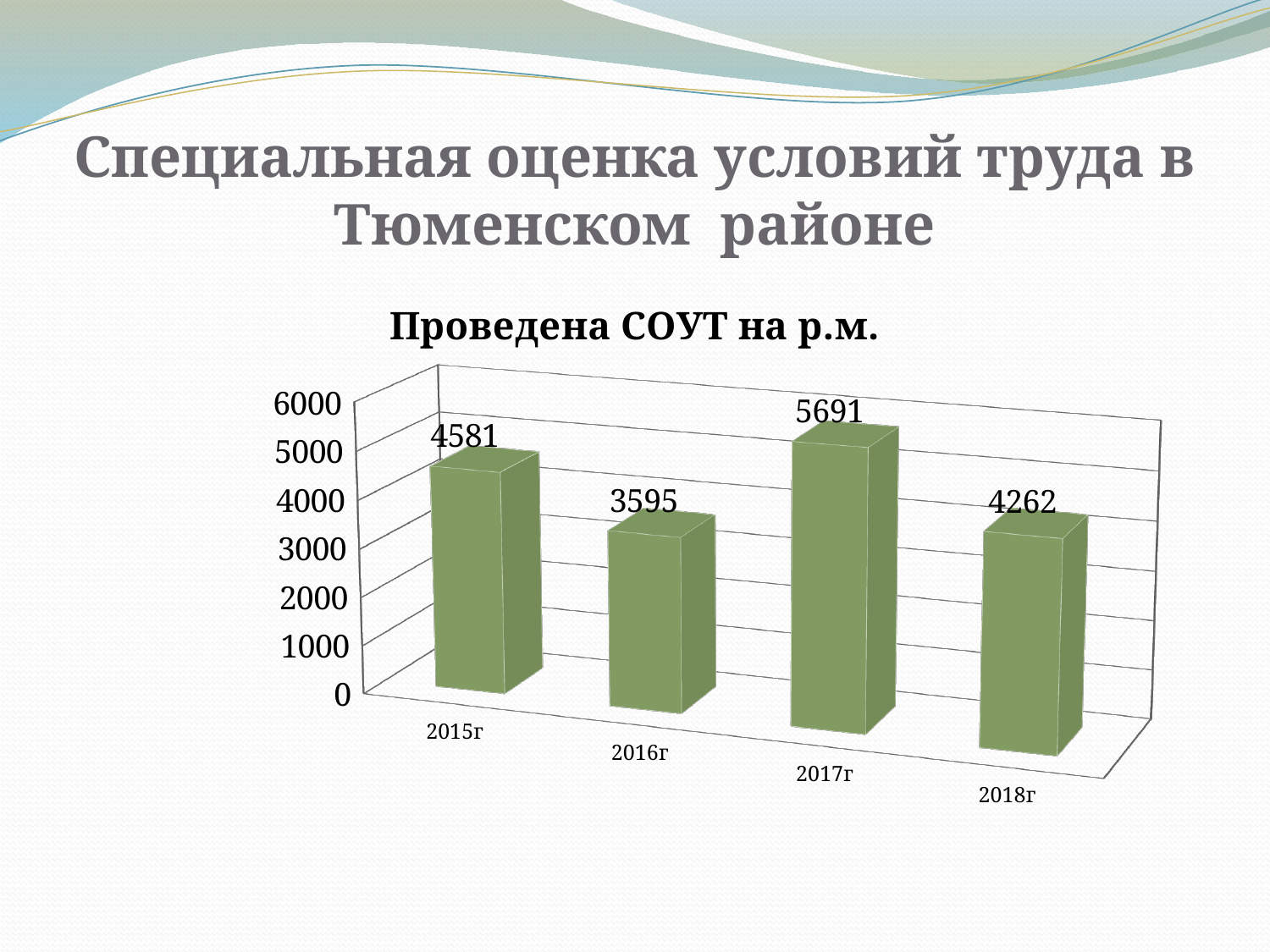
How many years are shown on the chart? 4 What is the difference between the values for 2017г and 2016г? 2096 What is the value for 2015г? 4581 Which is larger, the value for 2015г or the value for 2018г? 2015г What is the value for 2018г? 4262 What is the value for 2016г? 3595 Which year has the lowest value? 2016г What is the difference between the values for 2015г and 2018г? 319 What is the value for 2017г? 5691 Which year has the highest value? 2017г What is the title of the chart? Проведена СОУТ на р.м. What kind of chart is shown on the slide? bar chart